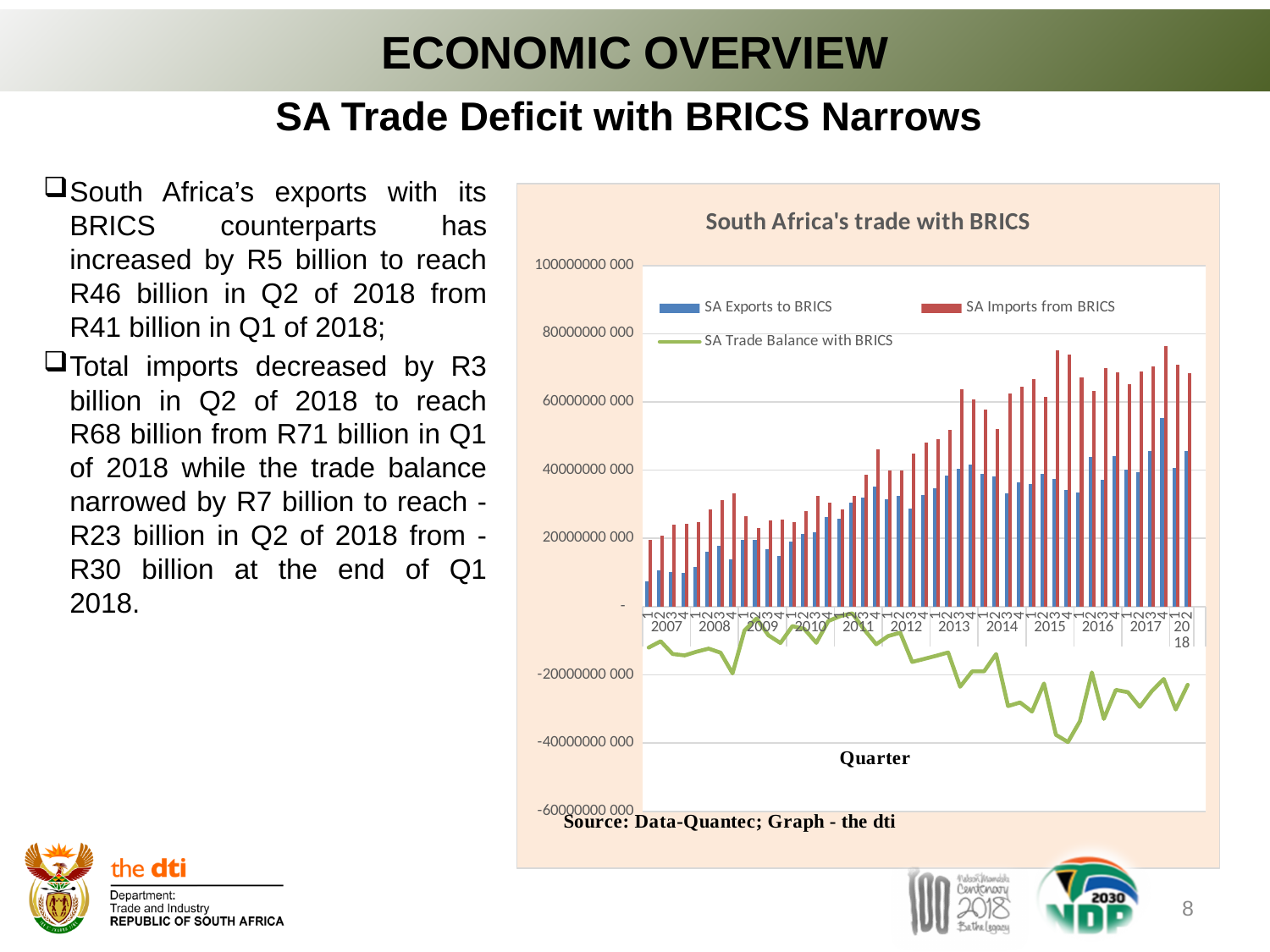
How many series does the legend of the chart list? 3 What is the title of the chart? South Africa's trade with BRICS How many years are labelled along the x axis of the chart? 12 In Q4 2015, which is larger: SA Exports to BRICS or SA Imports from BRICS? SA Imports from BRICS What kind of chart is shown on the slide? A combined bar and line chart Is the value for SA Exports to BRICS in Q1 2007 greater or less than 20000000 000? less Which series in the chart is plotted as a line rather than bars? SA Trade Balance with BRICS Is the value for SA Exports to BRICS in Q4 2017 greater or less than 40000000 000? greater Does the SA Trade Balance with BRICS line generally rise or fall from 2007 to 2018? Fall Is the value for SA Trade Balance with BRICS in Q1 2007 greater or less than -20000000 000? greater